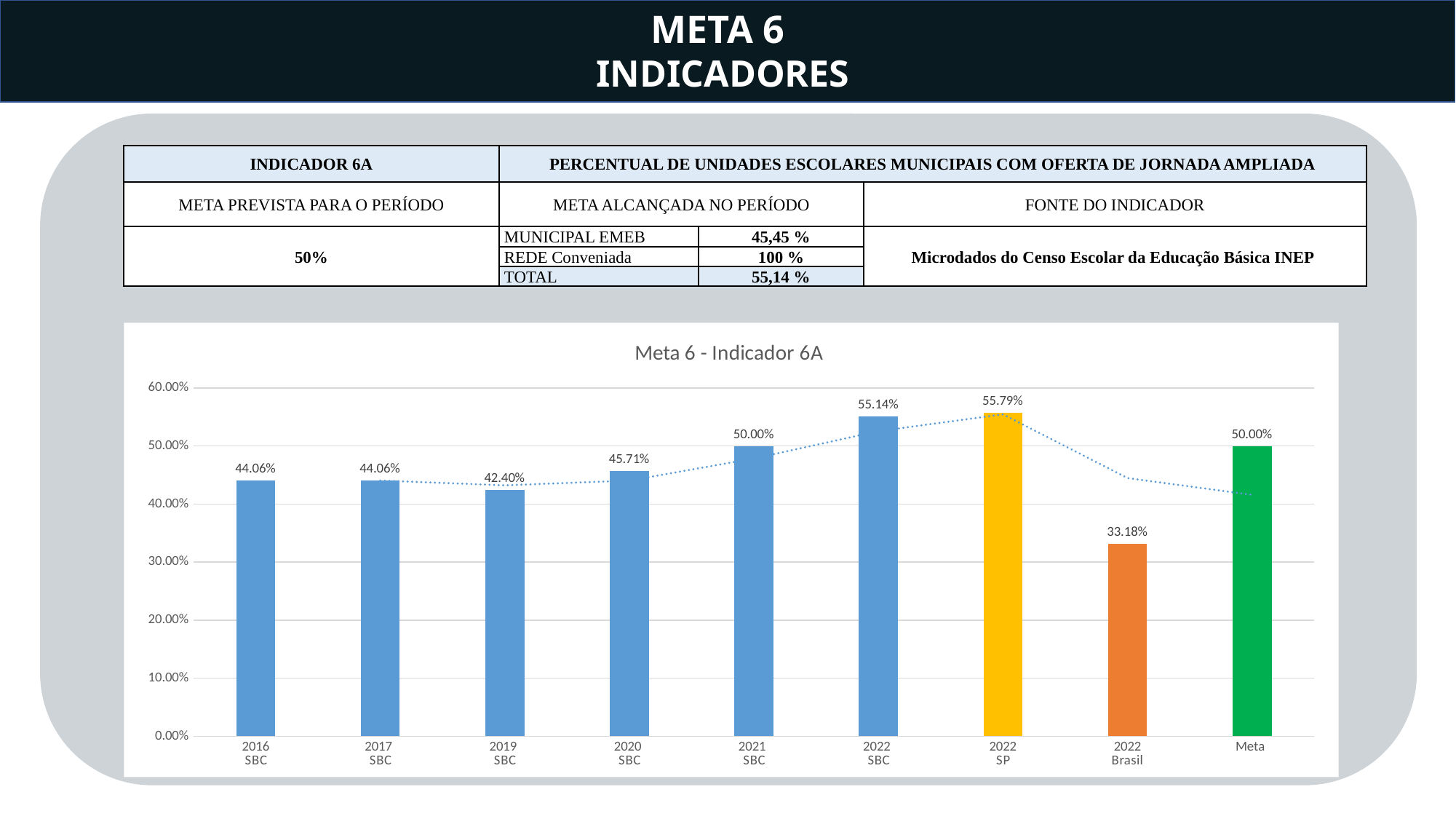
Which is larger, the value for 2020 SBC or the value for 2021 SBC? 2021 SBC What is the difference between the values for 2022 SBC and 2022 Brasil? 21.96% How many bars are plotted in the chart? 9 What is the value for 2016 SBC? 44.06% What kind of chart is shown on the slide? bar chart Do the SBC values rise or fall from 2019 to 2022? rise What is the value for 2019 SBC? 42.40% What is the value for the Meta bar? 50.00% What is the title of the chart? Meta 6 - Indicador 6A Which category has the highest value? 2022 SP Which category has the lowest value? 2022 Brasil What is the value for 2022 Brasil? 33.18%